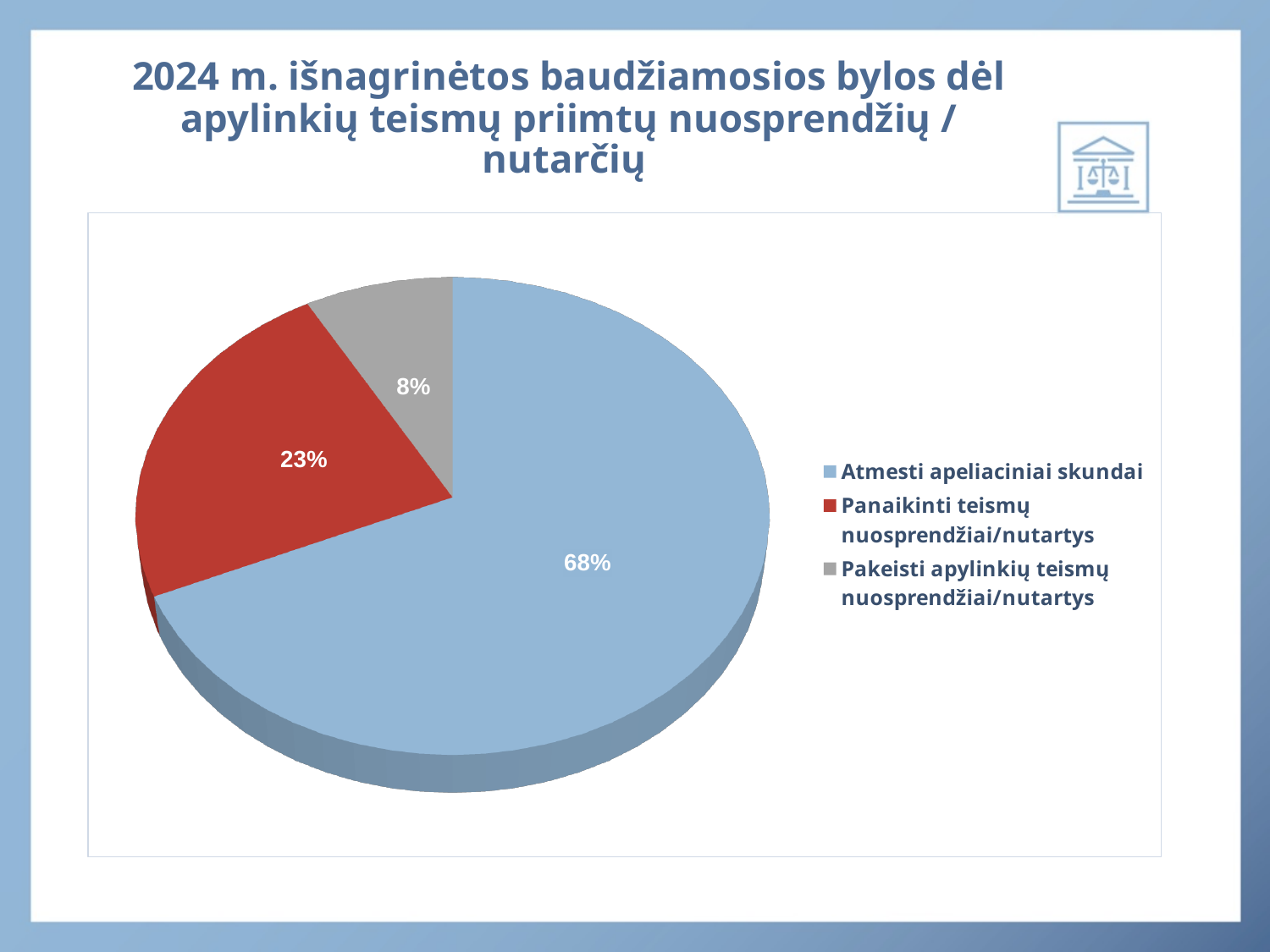
What share of the pie is labelled "Pakeisti apylinkių teismų nuosprendžiai/nutartys"? 8% What share of the pie is labelled "Atmesti apeliaciniai skundai"? 68% What share of the pie is labelled "Panaikinti teismų nuosprendžiai/nutartys"? 23% How many entries does the legend list? 3 Which category has the largest slice of the pie? Atmesti apeliaciniai skundai What is the title of the slide? 2024 m. išnagrinėtos baudžiamosios bylos dėl apylinkių teismų priimtų nuosprendžių / nutarčių What kind of chart is shown on the slide? pie chart What is the difference in percentage points between the "Atmesti apeliaciniai skundai" slice and the "Panaikinti teismų nuosprendžiai/nutartys" slice? 45 Which slice is larger: "Panaikinti teismų nuosprendžiai/nutartys" or "Pakeisti apylinkių teismų nuosprendžiai/nutartys"? Panaikinti teismų nuosprendžiai/nutartys How many slices does the pie chart have? 3 Which category has the smallest slice of the pie? Pakeisti apylinkių teismų nuosprendžiai/nutartys What colour is the slice for "Panaikinti teismų nuosprendžiai/nutartys"? red